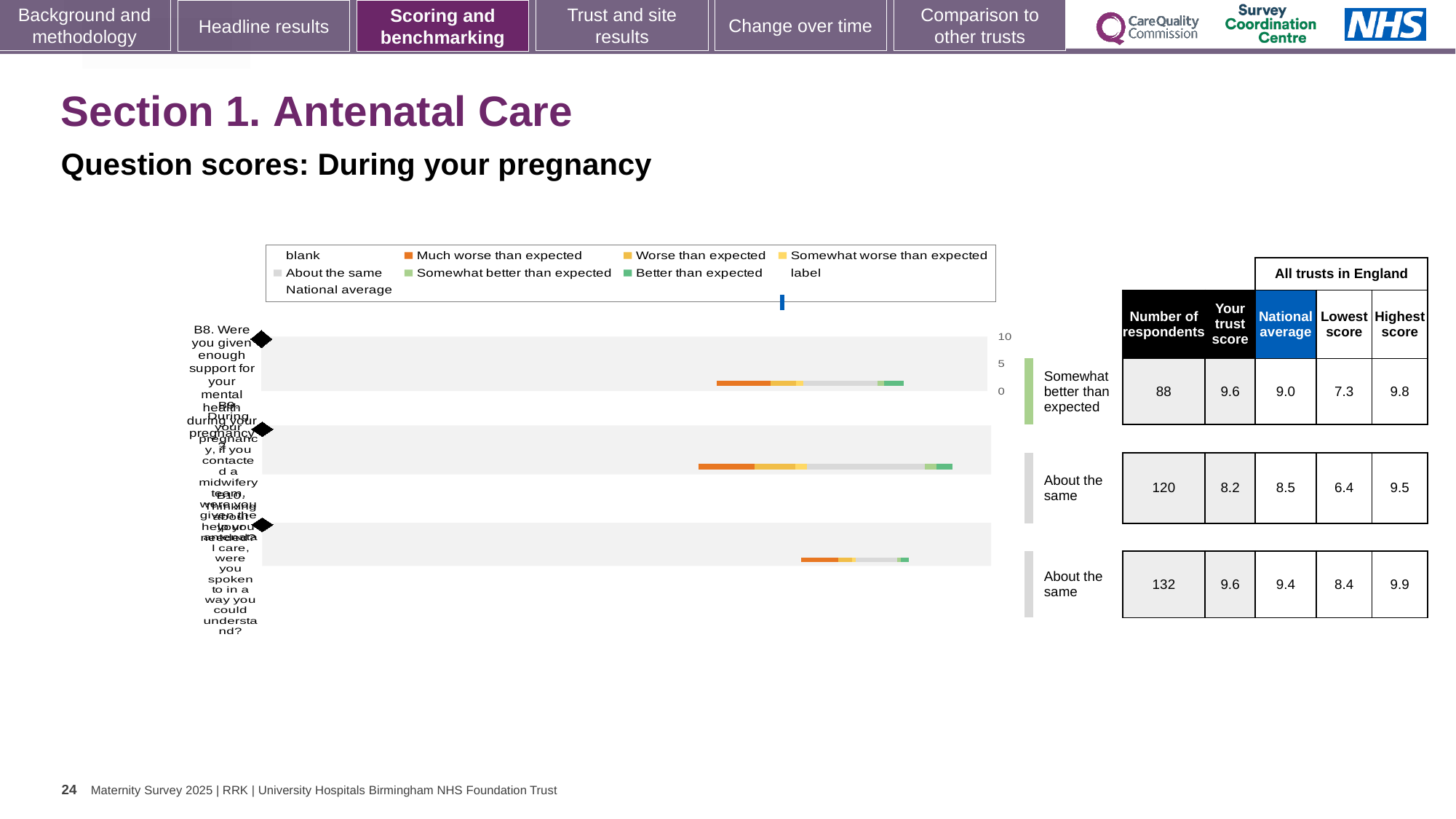
What colour does the legend use for 'Better than expected'? Green Which table row has the largest number of respondents? The third row (132) What colour does the legend use for 'Much worse than expected'? Orange How many survey questions (bars) are plotted in the chart? 3 In the table, what is the number of respondents for the first row (B8, support for mental health)? 88 In the table, what is the trust score for the first row (B8)? 9.6 In the table, what is the national average for the second row? 8.5 For the first row, what is the difference between the highest score and the lowest score? 2.5 For the second row, is the trust score or the national average larger? National average (8.5) What kind of chart is shown on the slide? Bar chart In the table, what is the highest score for the third row? 9.9 Which table row has the lowest 'Lowest score' value? The second row (6.4)